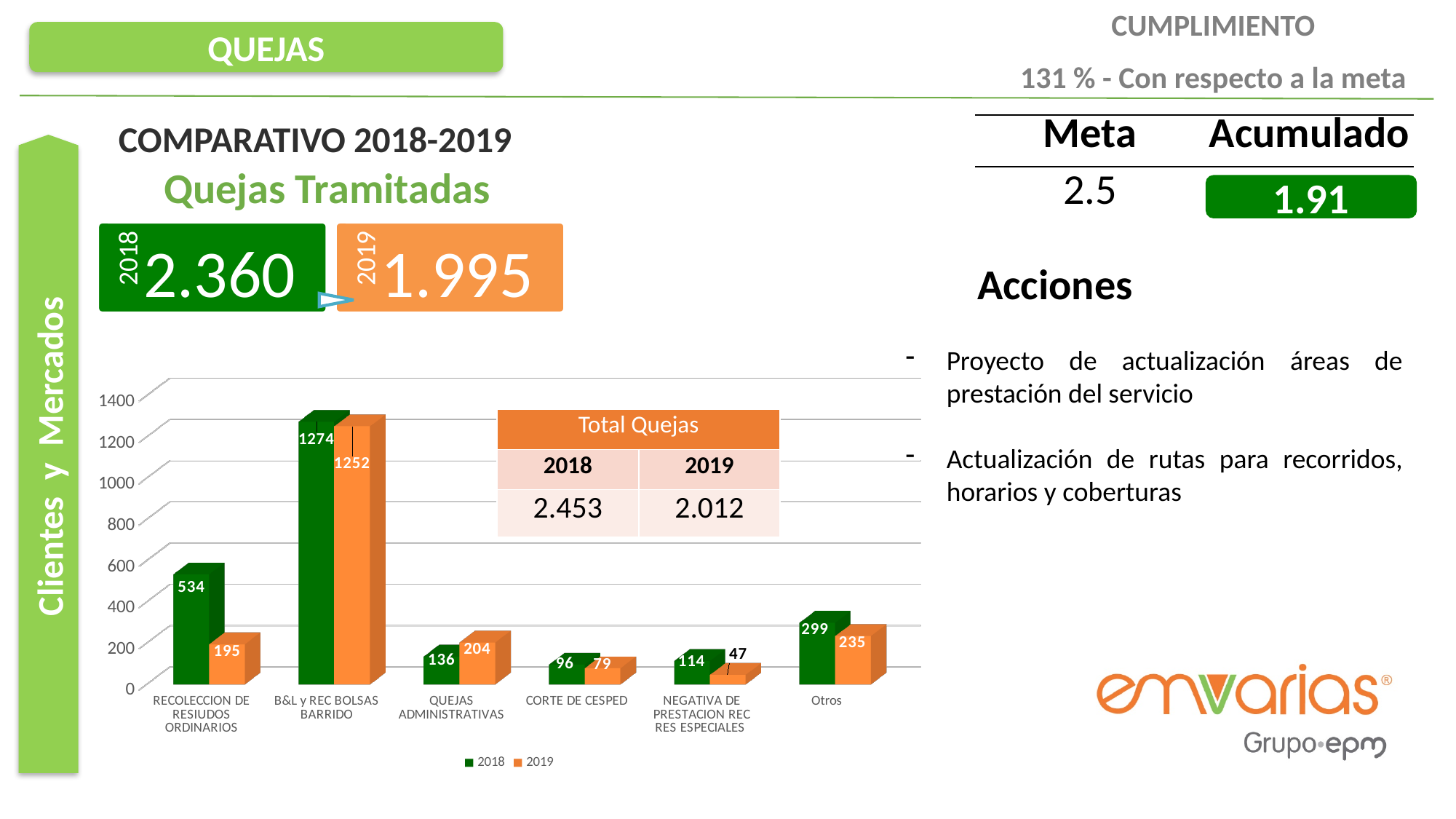
What is the 2019 value for B&L y REC BOLSAS BARRIDO? 1252 What is the difference between the 2018 and 2019 values for RECOLECCION DE RESIUDOS ORDINARIOS? 339 Which category has the highest 2018 value? B&L y REC BOLSAS BARRIDO How many categories are shown on the x axis of the chart? 6 Is the 2018 value for B&L y REC BOLSAS BARRIDO greater or less than 1200? greater What kind of chart is shown on the slide? bar chart How many series does the chart legend list? 2 For QUEJAS ADMINISTRATIVAS, which year has the larger value, 2018 or 2019? 2019 What is the 2019 value for NEGATIVA DE PRESTACION REC RES ESPECIALES? 47 Which category has the lowest 2019 value? NEGATIVA DE PRESTACION REC RES ESPECIALES What is the 2018 value for RECOLECCION DE RESIUDOS ORDINARIOS? 534 What is the 2018 value for Otros? 299